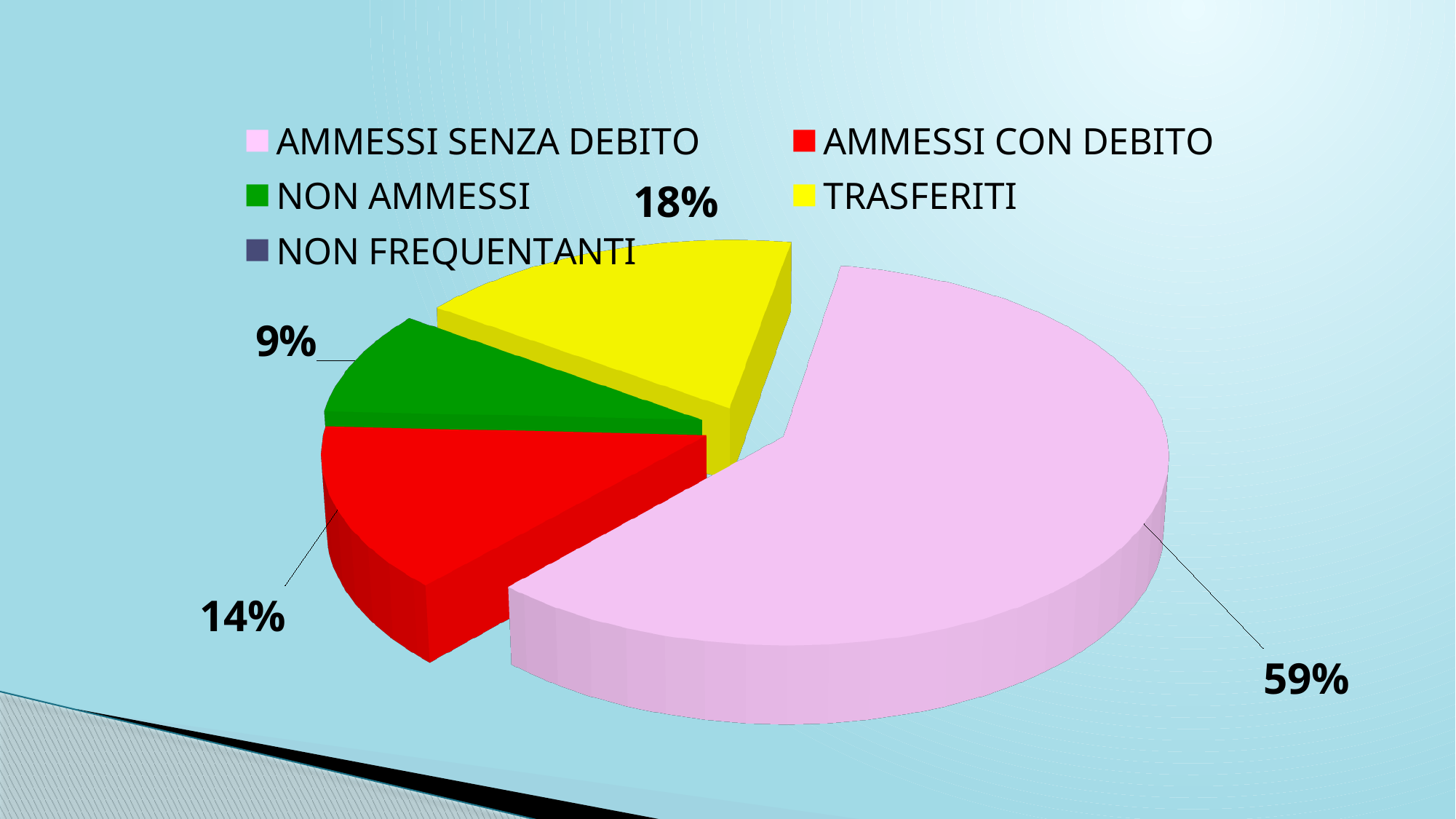
What share of the pie is AMMESSI SENZA DEBITO? 59% What share of the pie is TRASFERITI? 18% What is the difference in percentage points between AMMESSI SENZA DEBITO and TRASFERITI? 41 What kind of chart is shown on the slide? pie chart What share of the pie is NON AMMESSI? 9% What is the difference in percentage points between AMMESSI CON DEBITO and NON AMMESSI? 5 Which category has the largest slice of the pie? AMMESSI SENZA DEBITO What colour is the AMMESSI SENZA DEBITO slice? pink How many entries does the legend list? 5 Which labelled slice of the pie is the smallest? NON AMMESSI Which is larger, the TRASFERITI slice or the AMMESSI CON DEBITO slice? TRASFERITI